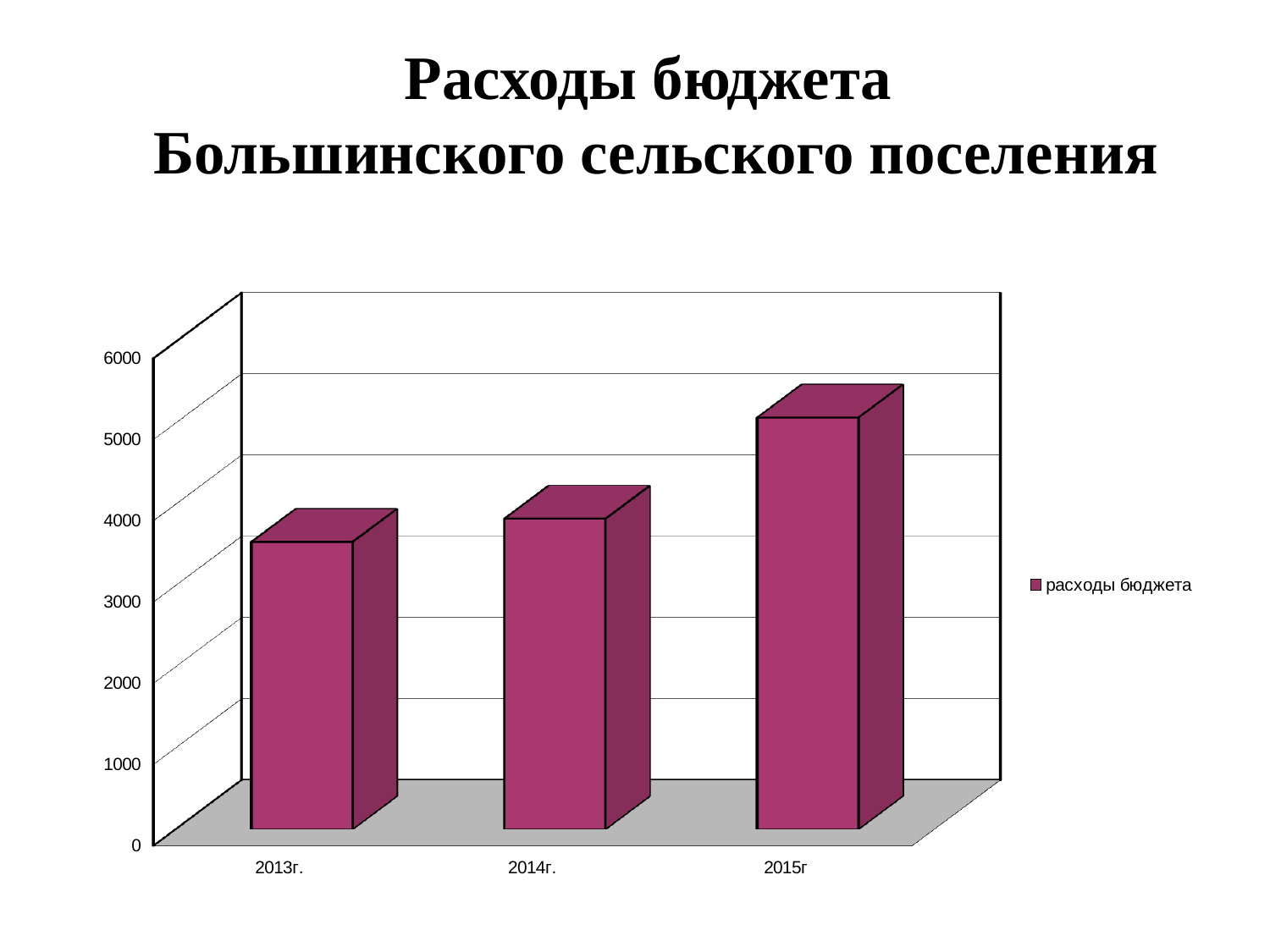
Is the value for 2013г. greater or less than 3000? greater What is the title of the slide? Расходы бюджета Большинского сельского поселения Which bar is taller, 2013г. or 2015г? 2015г What is the name of the series shown in the legend? расходы бюджета Which year has the lowest budget expenditure bar? 2013г. Is the value for 2015г greater or less than 6000? less What kind of chart is shown on the slide? bar chart Do the budget expenditure values rise or fall from 2013г. to 2015г? rise How many years (categories) are shown on the x axis of the chart? 3 Which year has the highest budget expenditure bar? 2015г How many series does the legend list? 1